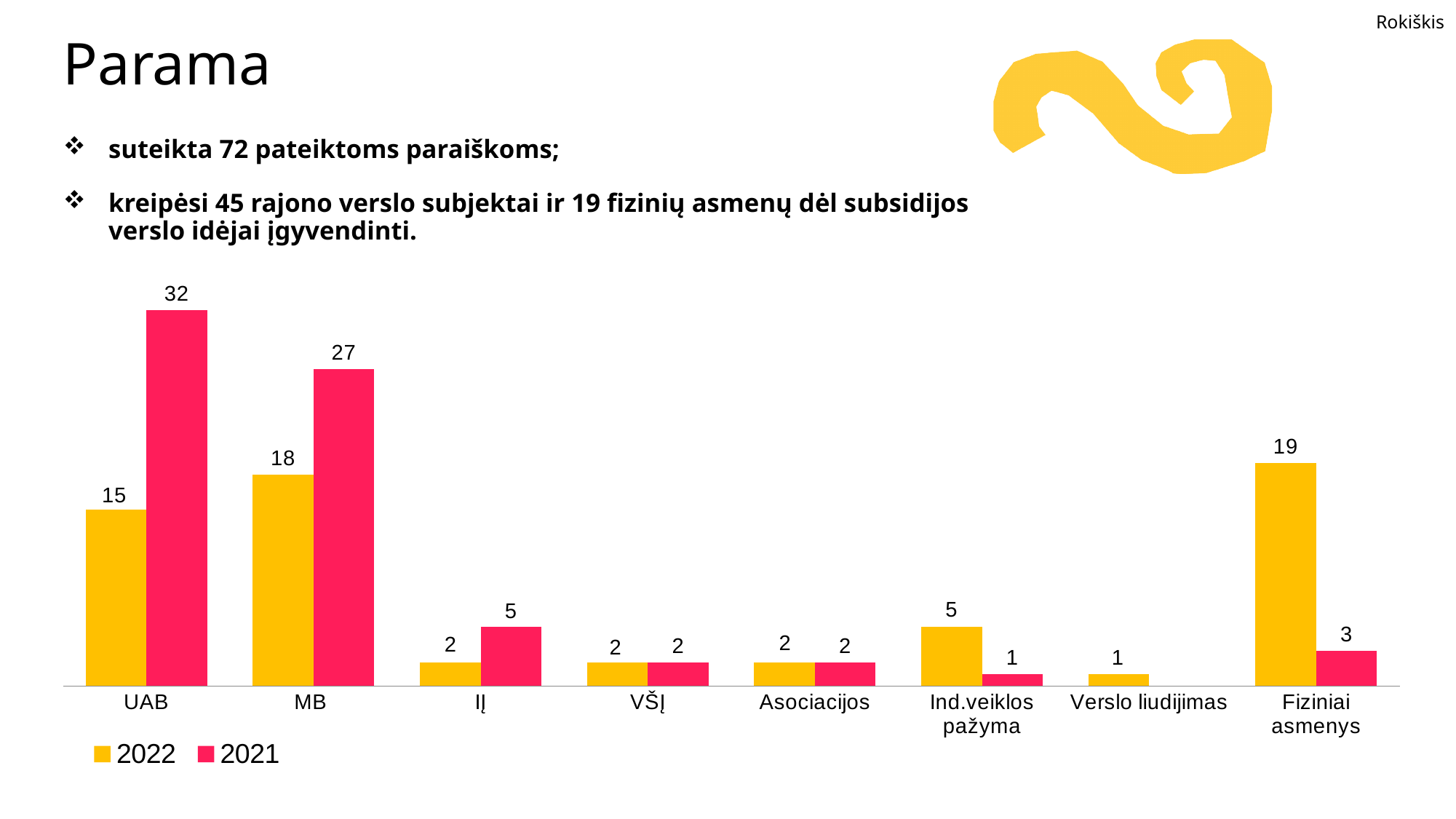
What kind of chart is shown on the slide? bar chart What is the 2021 value for IĮ? 5 How many categories are shown on the x axis? 8 What is the 2022 value for UAB? 15 Which category has the highest 2021 value? UAB How many series does the legend list? 2 Which category has the lowest 2022 value? Verslo liudijimas What is the difference between the 2021 and 2022 values for UAB? 17 What is the 2022 value for Fiziniai asmenys? 19 What is the 2021 value for MB? 27 Which is larger for Ind.veiklos pažyma, the 2022 value or the 2021 value? 2022 Which colour represents the 2021 series in the legend? red